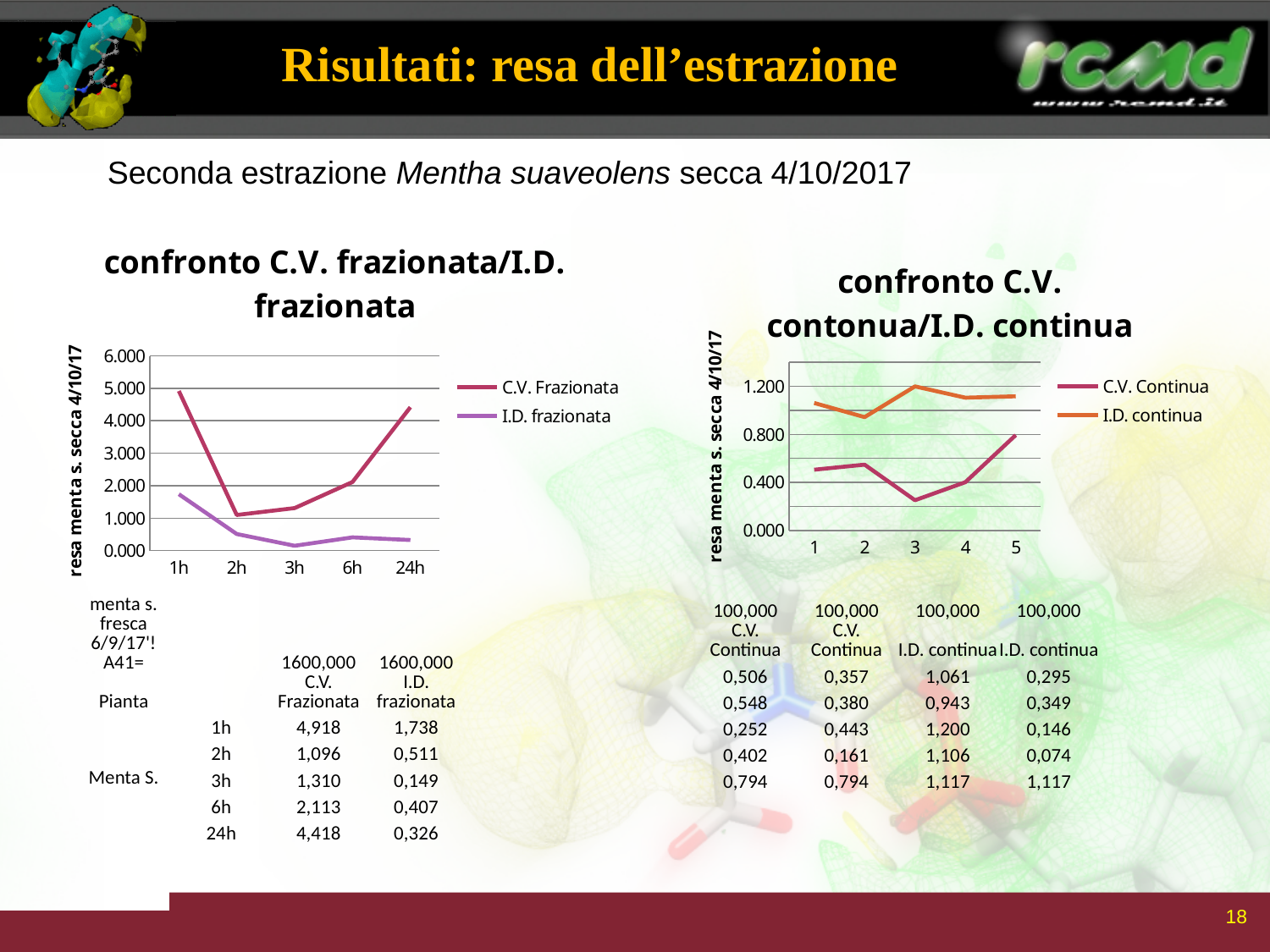
How many categories are on the x axis of the left chart? 5 In the left chart, at which time point is the C.V. Frazionata value highest? 1h In the left chart, at which time point is the I.D. frazionata value lowest? 3h In the right chart, which series is higher at point 1, C.V. Continua or I.D. continua? I.D. continua How many series does the legend of the left chart list? 2 In the left chart, is the I.D. frazionata value at 2h greater or less than 1.000? less In the left chart, which series is higher at 6h, C.V. Frazionata or I.D. frazionata? C.V. Frazionata In the left chart, is the C.V. Frazionata value at 24h greater or less than 4.000? greater What kind of chart is the left chart titled 'confronto C.V. frazionata/I.D. frazionata'? line chart In the right chart, is the I.D. continua value at point 3 greater or less than 0.800? greater How many series does the legend of the right chart titled 'confronto C.V. contonua/I.D. continua' list? 2 In the right chart, at which x-axis point is the C.V. Continua value lowest? 3